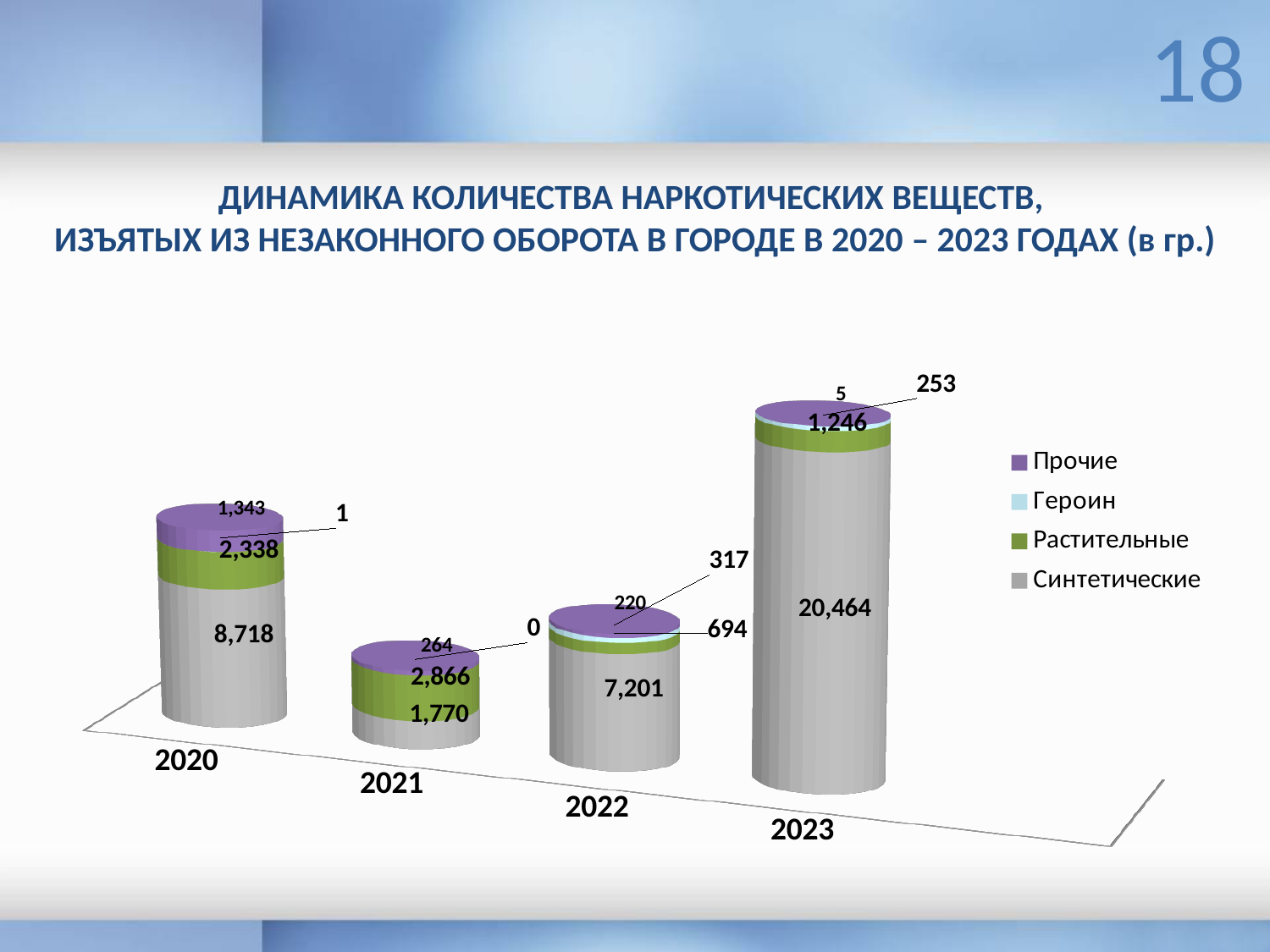
What is the difference between the Синтетические values for 2023 and 2020? 11,746 How many series does the legend list? 4 In which year is the value for Синтетические the lowest? 2021 How many years are shown on the x axis? 4 What is the value for Прочие in 2020? 1,343 Which is larger: the Растительные value in 2020 or in 2022? 2020 What is the value for Героин in 2022? 317 What is the total of the stacked bar for 2021? 4,900 What is the value for Растительные in 2021? 2,866 What is the value for Синтетические in 2023? 20,464 What kind of chart is shown on the slide? Stacked bar chart In which year is the value for Прочие the highest? 2020